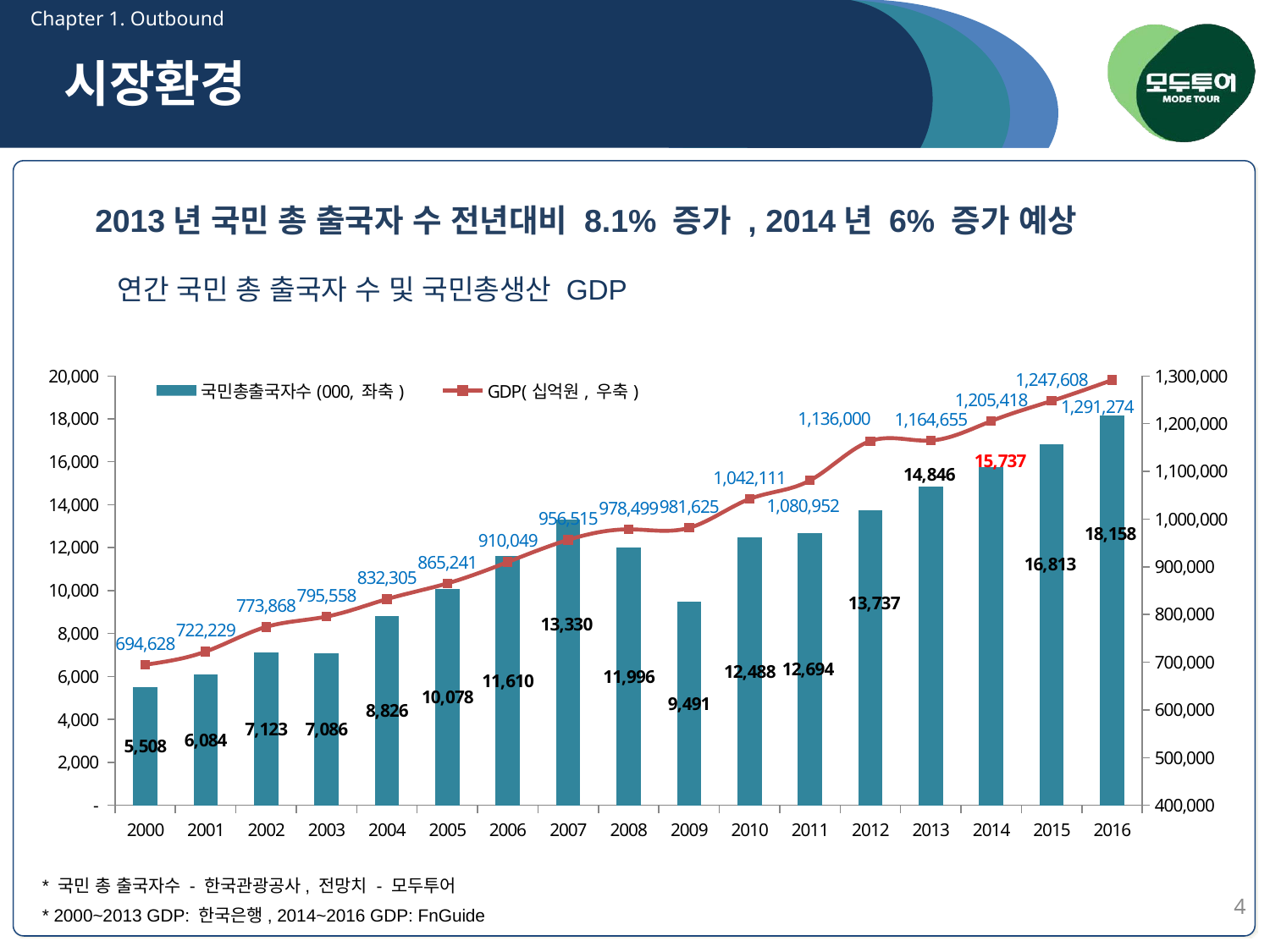
What kind of chart is this? Combined bar and line chart What is the GDP value for 2016? 1,291,274 How many series does the legend list? 2 Which year has the highest 국민총출국자수? 2016 Which year has the larger 국민총출국자수, 2007 or 2008? 2007 What is the difference in 국민총출국자수 between 2016 and 2015? 1,345 What is the value of 국민총출국자수 for 2013? 14,846 What is the GDP value for 2000? 694,628 Does the GDP line rise or fall from 2000 to 2016? Rises Which year has the lowest 국민총출국자수? 2000 How many years are shown on the x axis? 17 What is the value of 국민총출국자수 for 2009? 9,491